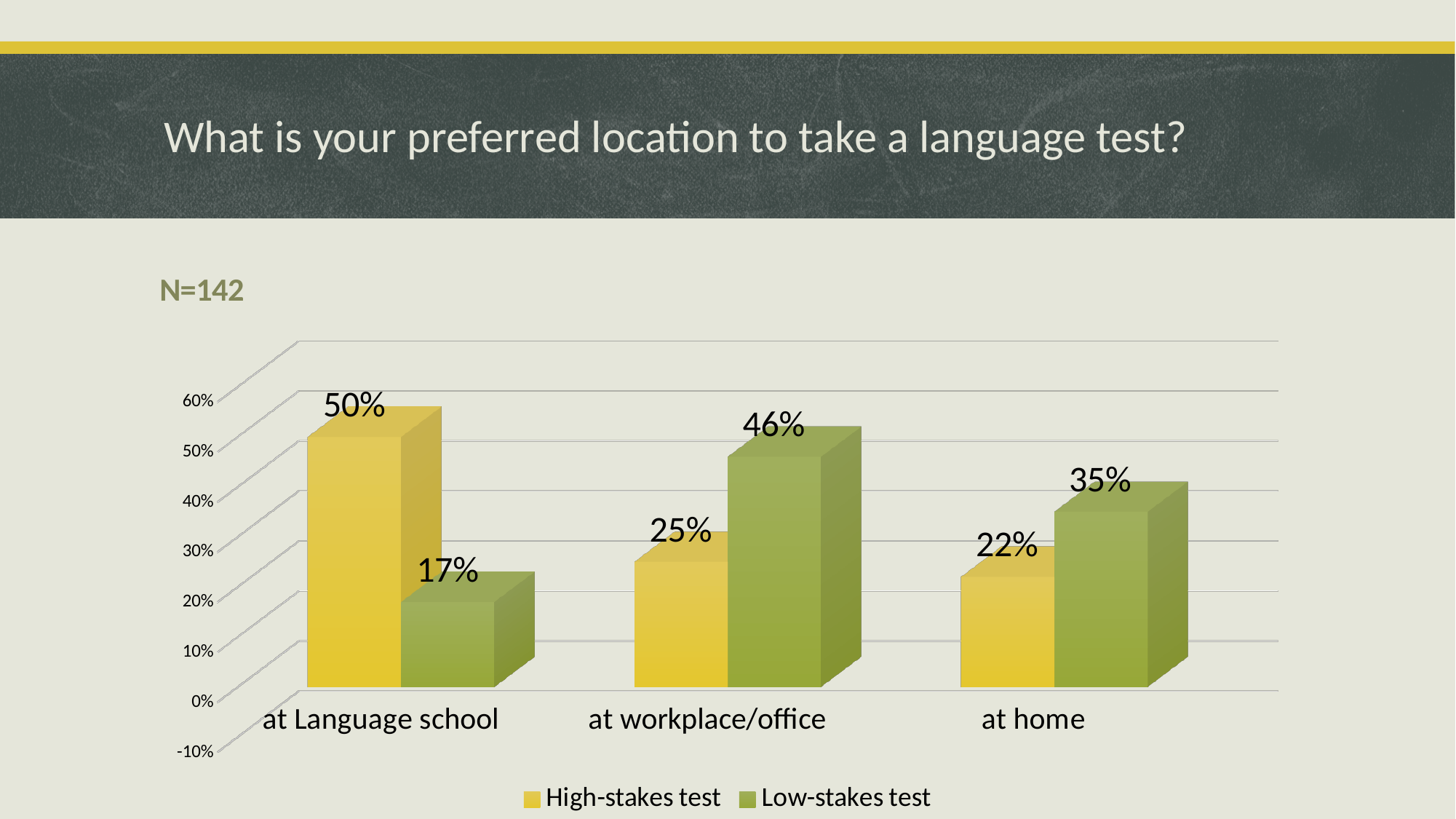
What sample size is stated above the chart? N=142 How many series does the legend list? 2 What kind of chart is shown on the slide? bar chart Which location has the lowest Low-stakes test value? at Language school What is the High-stakes test value for at Language school? 50% What is the Low-stakes test value for at home? 35% How many locations are shown on the x axis? 3 Which is larger for at workplace/office: the High-stakes test value or the Low-stakes test value? Low-stakes test What is the difference between the High-stakes test and Low-stakes test values for at Language school? 33% Which location has the highest High-stakes test value? at Language school What is the High-stakes test value for at home? 22% What is the Low-stakes test value for at workplace/office? 46%